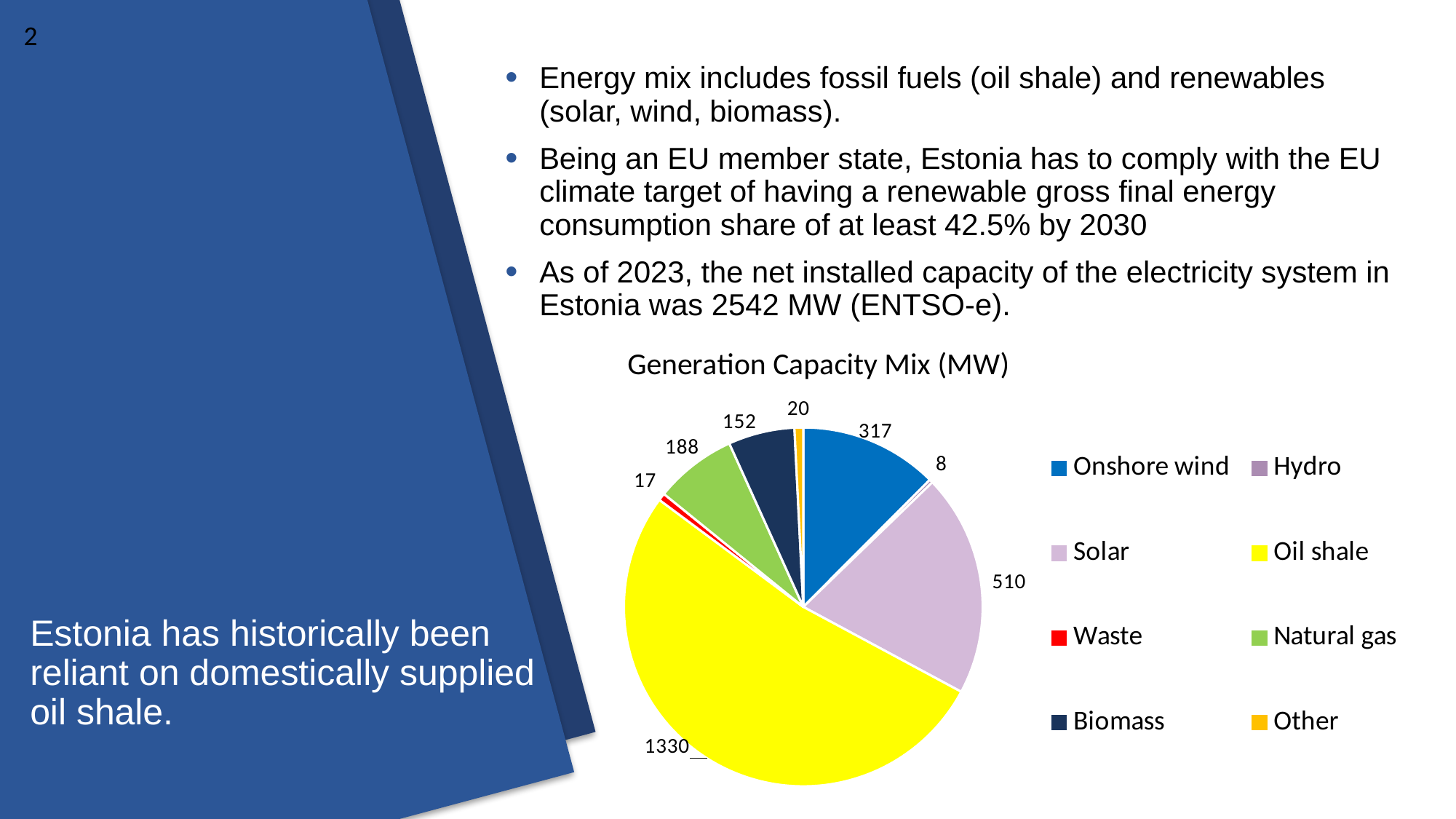
Which is larger, the value for Biomass or the value for Natural gas? Natural gas How many categories does the legend list? 8 What is the total of all the slices in the pie chart? 2542 What is the generation capacity value for Natural gas? 188 Which category has the smallest slice of the pie? Hydro Which category has the largest slice of the pie? Oil shale What is the difference between the Oil shale value and the Solar value? 820 What is the generation capacity value for Solar? 510 What is the title of the chart? Generation Capacity Mix (MW) What type of chart is shown on the slide? Pie chart What is the generation capacity value for Onshore wind? 317 What is the generation capacity value for Oil shale? 1330